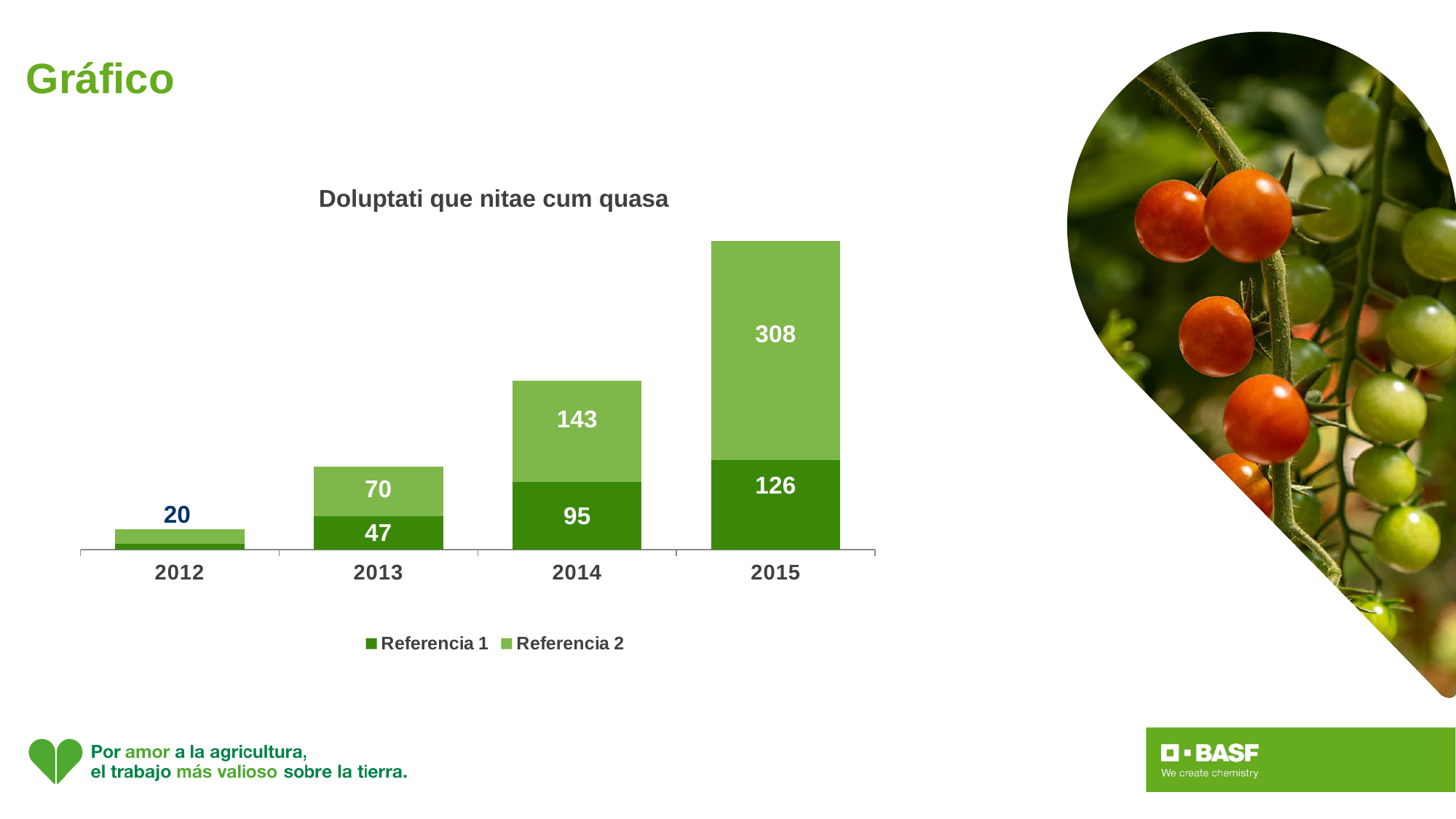
What is the difference between Referencia 2 in 2015 and Referencia 2 in 2014? 165 How many years are shown on the x axis? 4 What is the value of Referencia 2 in 2015? 308 What value is labelled on the 2012 bar? 20 Which is larger: Referencia 1 in 2015 or Referencia 2 in 2014? Referencia 2 in 2014 What kind of chart is shown on the slide? Stacked bar chart Which year has the lowest total bar? 2012 How many series does the legend list? 2 What is the value of Referencia 1 in 2013? 47 What is the value of Referencia 1 in 2014? 95 What is the total of the stacked bar for 2015? 434 In which year is Referencia 2 highest? 2015